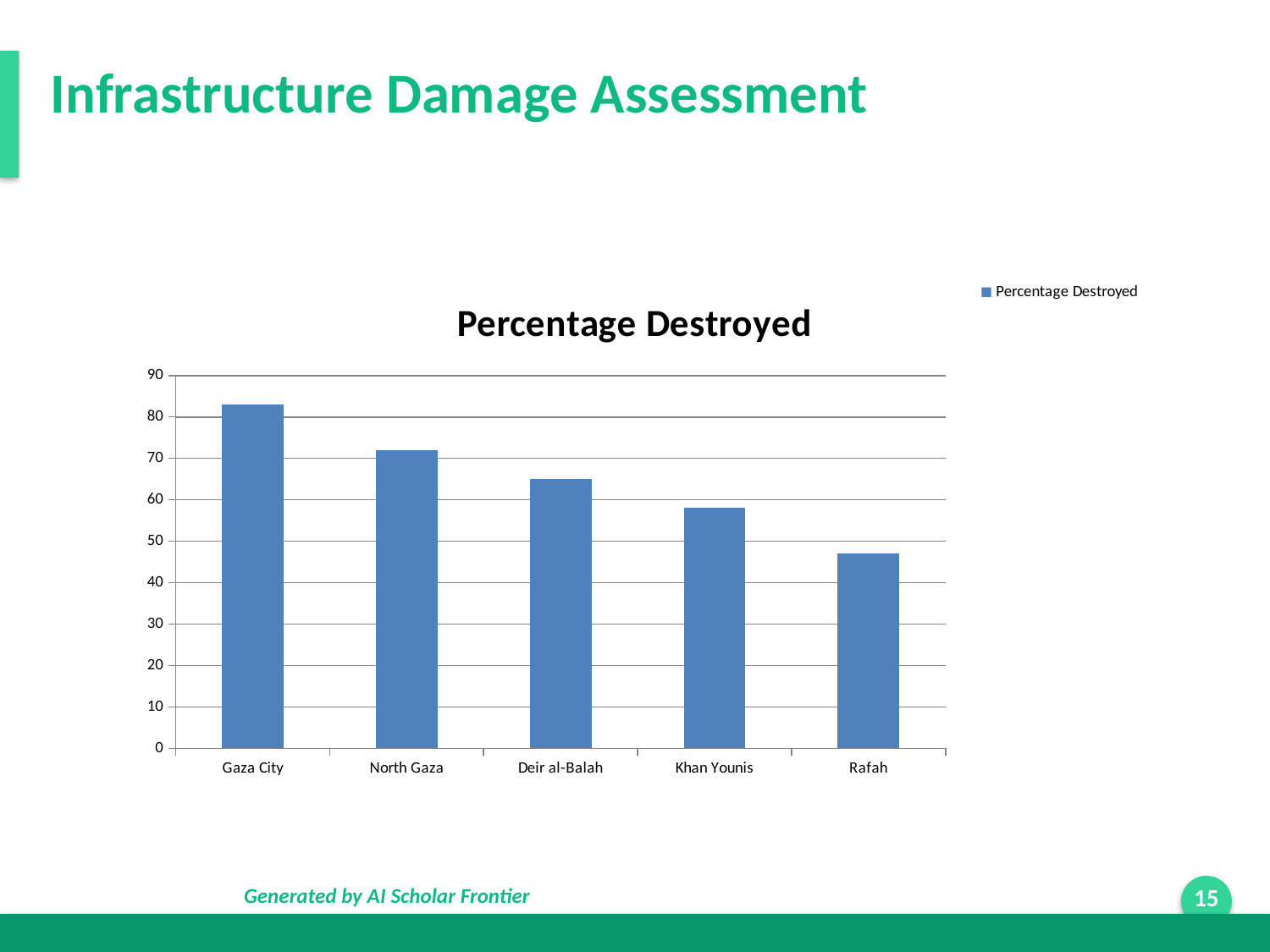
Is the value for Gaza City greater or less than 80? greater What type of chart is shown on the slide? bar chart Which category has the highest Percentage Destroyed? Gaza City What is the title of the chart? Percentage Destroyed Do the values rise or fall moving from Gaza City to Rafah along the x axis? fall Is the value for Rafah greater or less than 50? less How many series does the legend list? 1 Which is larger, the value for Deir al-Balah or the value for Khan Younis? Deir al-Balah Which category has the lowest Percentage Destroyed? Rafah How many categories are shown on the x axis? 5